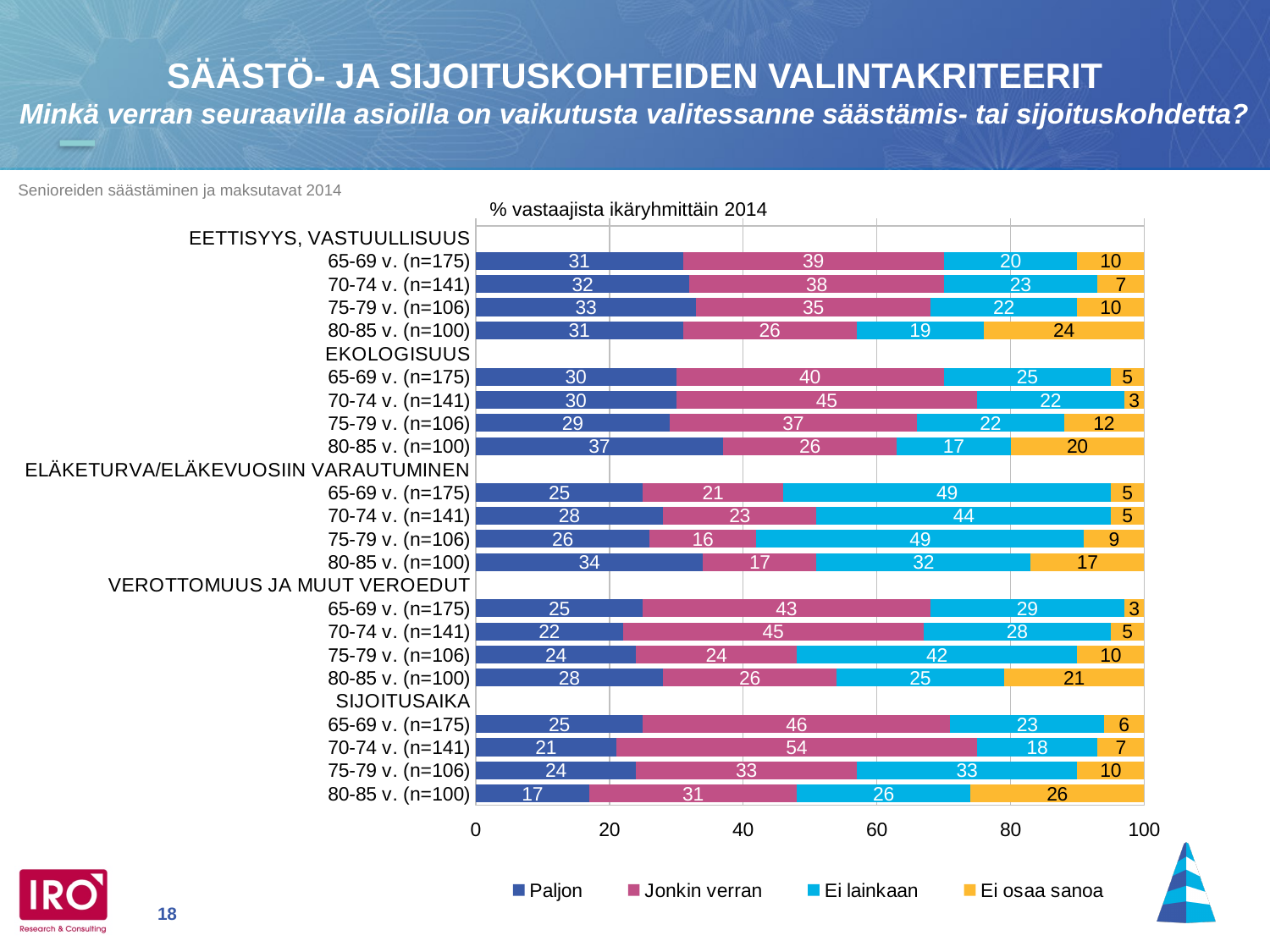
Under EETTISYYS, VASTUULLISUUS, is the 'Ei osaa sanoa' value larger for 80-85 v. (n=100) or for 70-74 v. (n=141)? 80-85 v. (n=100) Which bar has the lowest 'Paljon' value? 80-85 v. (n=100) under SIJOITUSAIKA What is the 'Ei osaa sanoa' value for the 80-85 v. (n=100) group under SIJOITUSAIKA? 26 What is the 'Ei lainkaan' value for the 65-69 v. (n=175) group under ELÄKETURVA/ELÄKEVUOSIIN VARAUTUMINEN? 49 What is the total of the stacked bar for 65-69 v. (n=175) under EETTISYYS, VASTUULLISUUS? 100 Which bar has the highest 'Jonkin verran' value? 70-74 v. (n=141) under SIJOITUSAIKA How many stacked bars (age-group rows) are plotted in the chart? 20 Under VEROTTOMUUS JA MUUT VEROEDUT, what is the difference between the 'Jonkin verran' values for 70-74 v. (n=141) and 75-79 v. (n=106)? 21 What kind of chart is shown on the slide? Stacked bar chart How many series does the legend list? 4 What is the title printed above the chart area? % vastaajista ikäryhmittäin 2014 What is the 'Paljon' value for the 80-85 v. (n=100) group under EKOLOGISUUS? 37